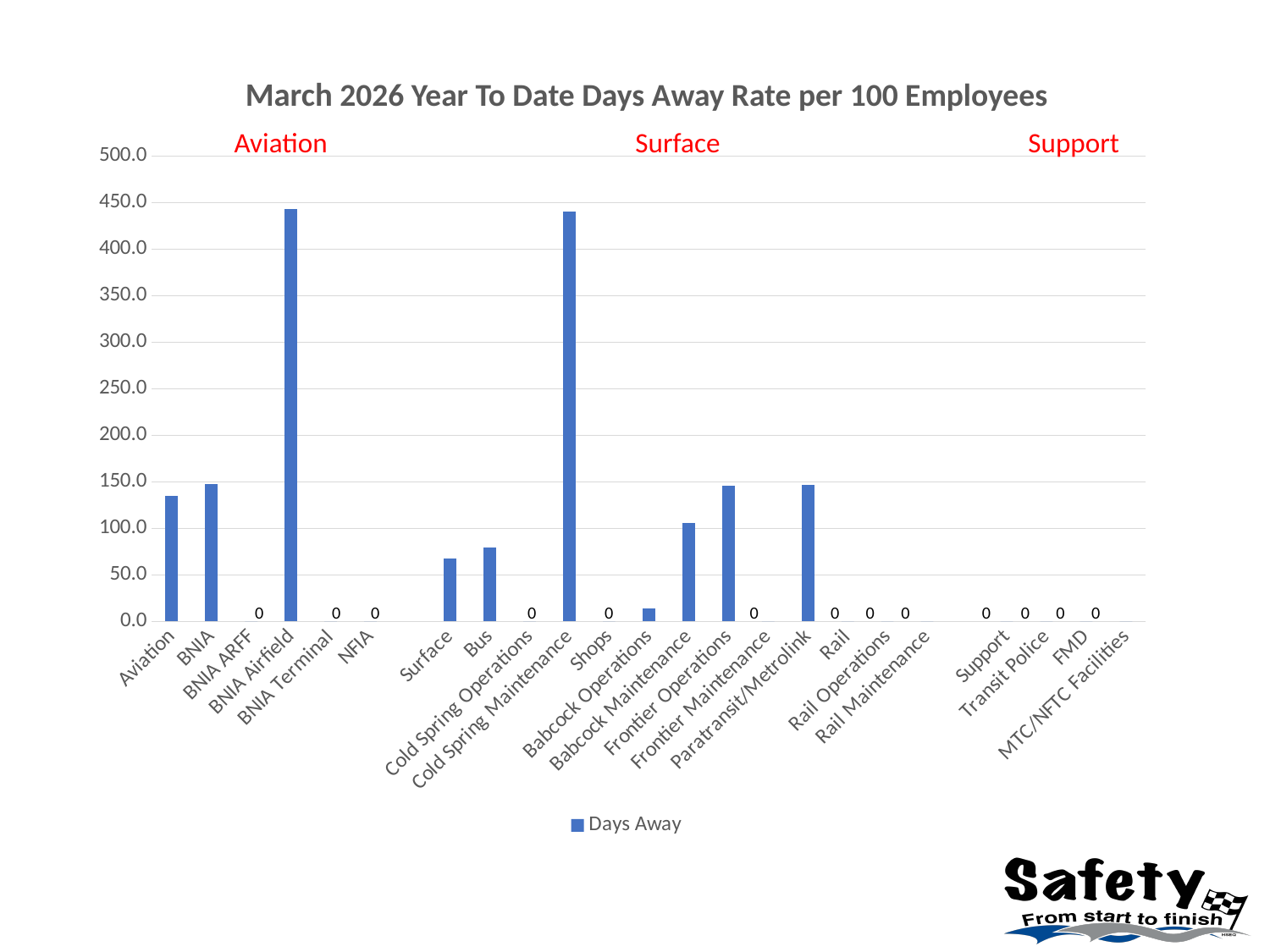
Is the value for Aviation greater or less than 100? greater What is the Days Away value for Rail Operations? 0 Which has the larger value, Aviation or Surface? Aviation Is the value for BNIA Airfield greater or less than 400? greater What is the title of the chart? March 2026 Year To Date Days Away Rate per 100 Employees Is the value for Surface greater or less than 100? less What is the Days Away value for NFIA? 0 Which has the larger value, Babcock Maintenance or Babcock Operations? Babcock Maintenance How many series does the legend list? 1 What kind of chart is shown on the slide? bar chart How many categories are shown on the x axis? 23 How many categories are labelled with a value of 0? 13